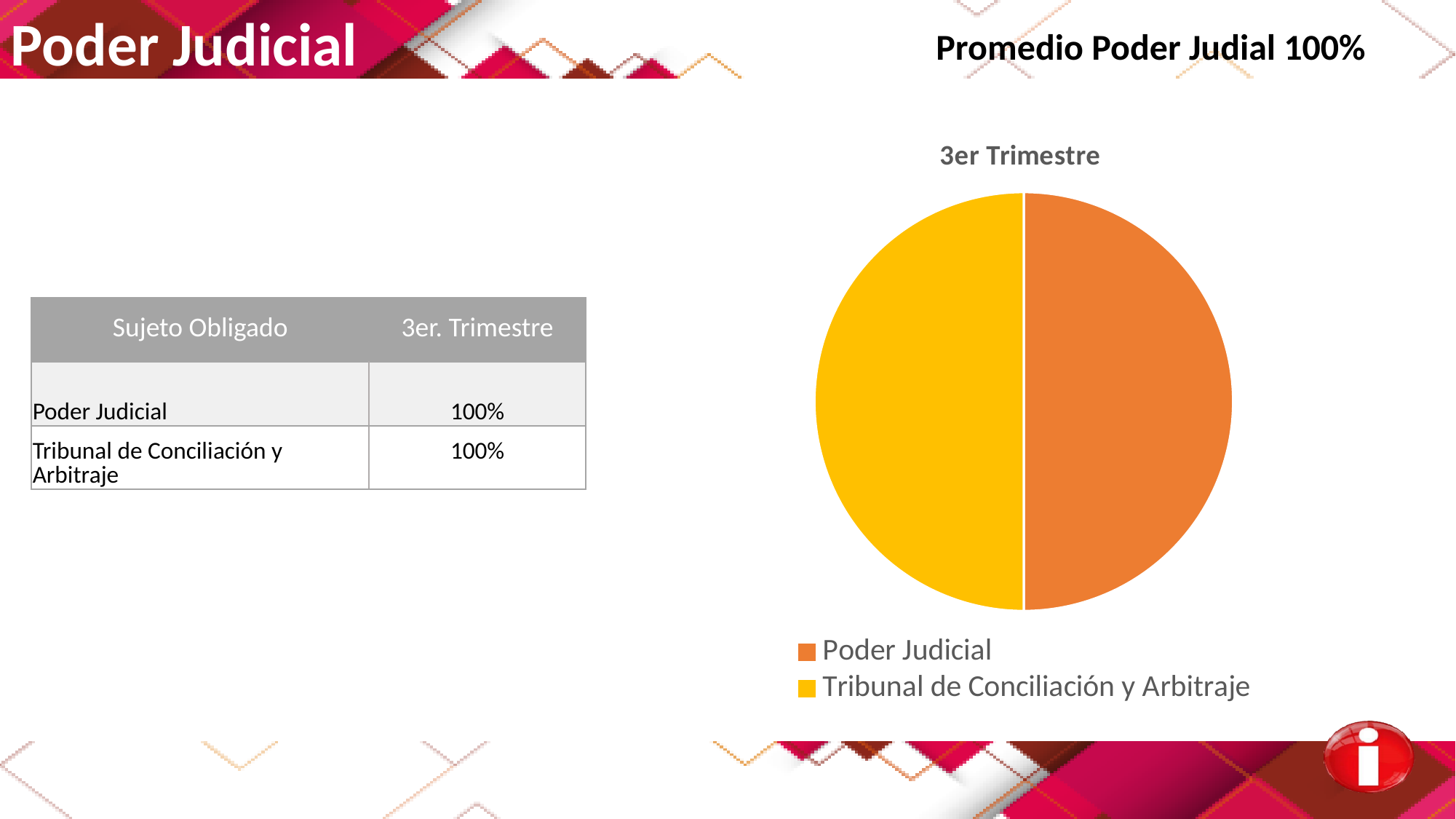
Which slice of the pie chart is yellow? Tribunal de Conciliación y Arbitraje How many entries does the legend of the pie chart list? 2 Which legend entry is shown in orange in the pie chart? Poder Judicial Are the two slices of the pie chart equal in size? yes What is the title of the pie chart? 3er Trimestre What share of the pie does the Poder Judicial slice take? half How many slices does the pie chart have? 2 What kind of chart is shown on the slide? pie chart